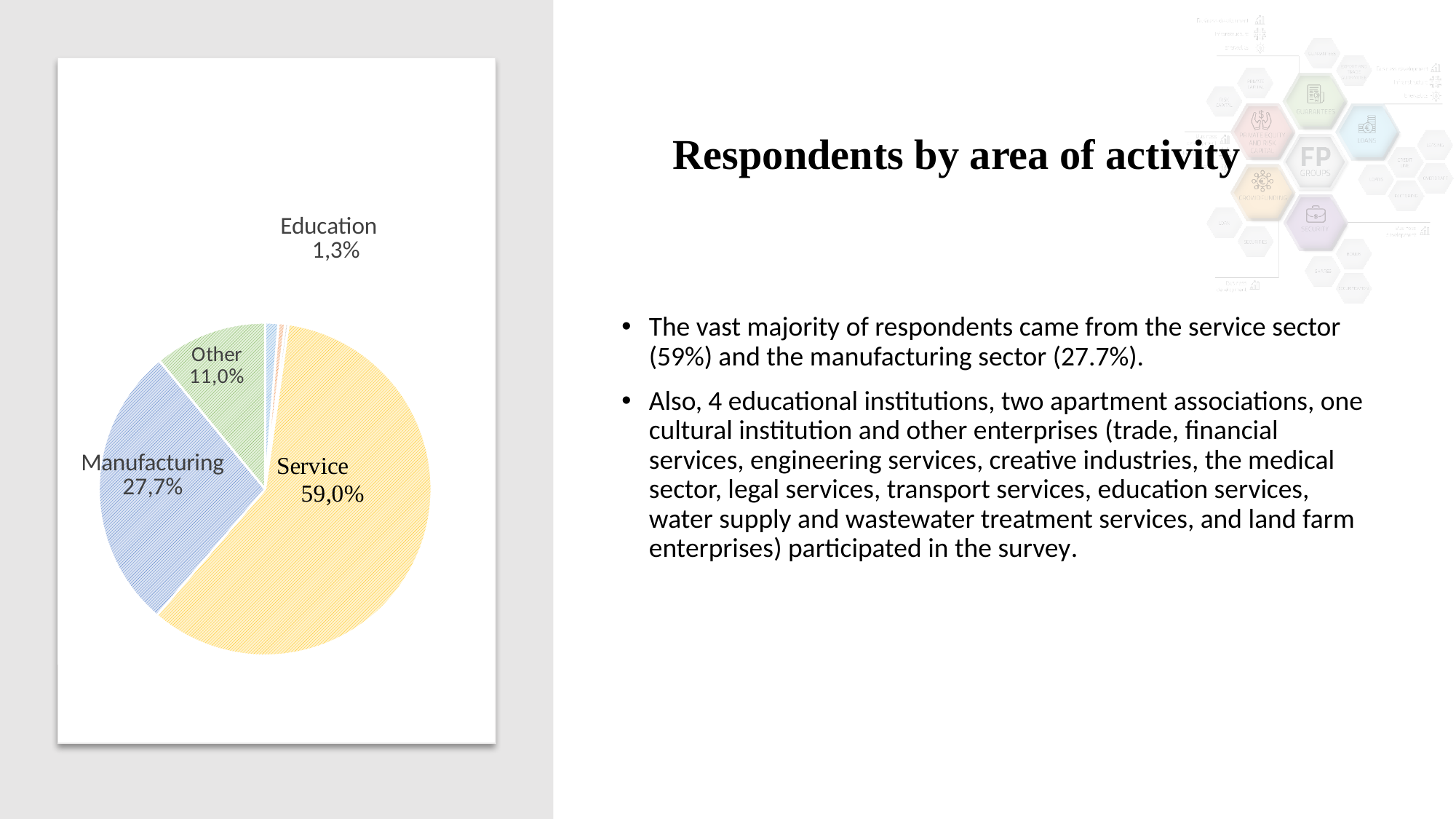
What is the combined share of the four labelled slices (Service, Manufacturing, Other, Education)? 99,0% What is the value shown for the Other slice in the pie chart? 11,0% What is the title of the slide containing the pie chart? Respondents by area of activity What percentage is labelled for Education in the pie chart? 1,3% Which slice is larger in the pie chart, Other or Education? Other What is the difference between the Manufacturing and Other slices in the pie chart? 16,7% What is the difference in percentage points between the Service and Manufacturing slices? 31,3% What type of chart is shown on the slide? Pie chart What percentage does the Manufacturing slice represent in the pie chart? 27,7% Which labelled sector has the largest share in the pie chart? Service Which slice is larger in the pie chart, Manufacturing or Other? Manufacturing What share of respondents came from the Service sector according to the pie chart? 59,0%